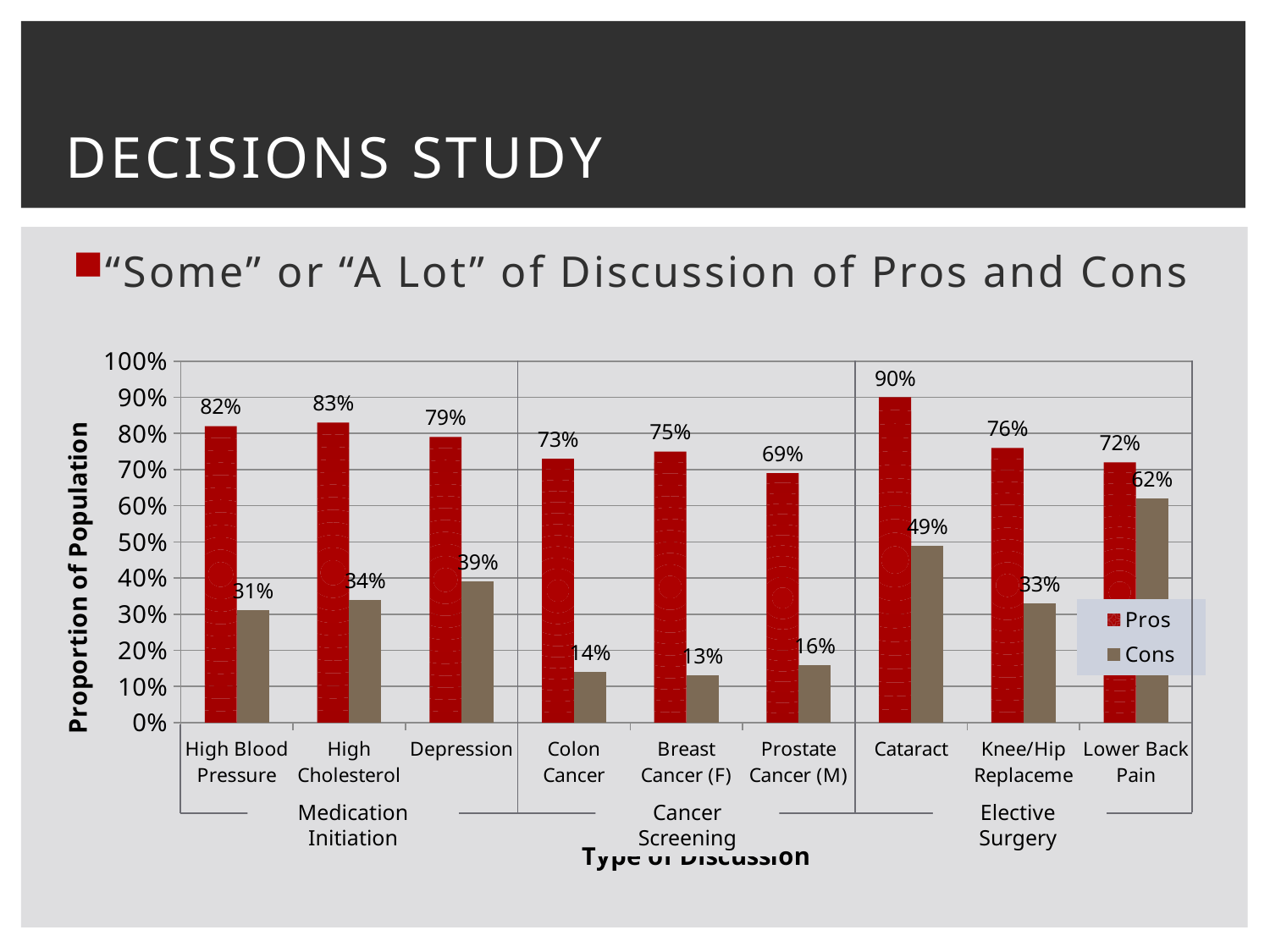
Is the Pros value for Prostate Cancer (M) greater or less than 70%? less Which category has the highest Pros value? Cataract How many categories are shown on the x axis? 9 Which is larger, the Cons value for Cataract or the Cons value for Depression? Cataract What is the Cons value for Breast Cancer (F)? 13% Which category has the lowest Cons value? Breast Cancer (F) What is the difference between the Pros and Cons values for Colon Cancer? 59% How many series does the legend list? 2 What is the Cons value for Lower Back Pain? 62% What kind of chart is shown on the slide? bar chart What is the Pros value for Cataract? 90% What is the label of the y axis? Proportion of Population